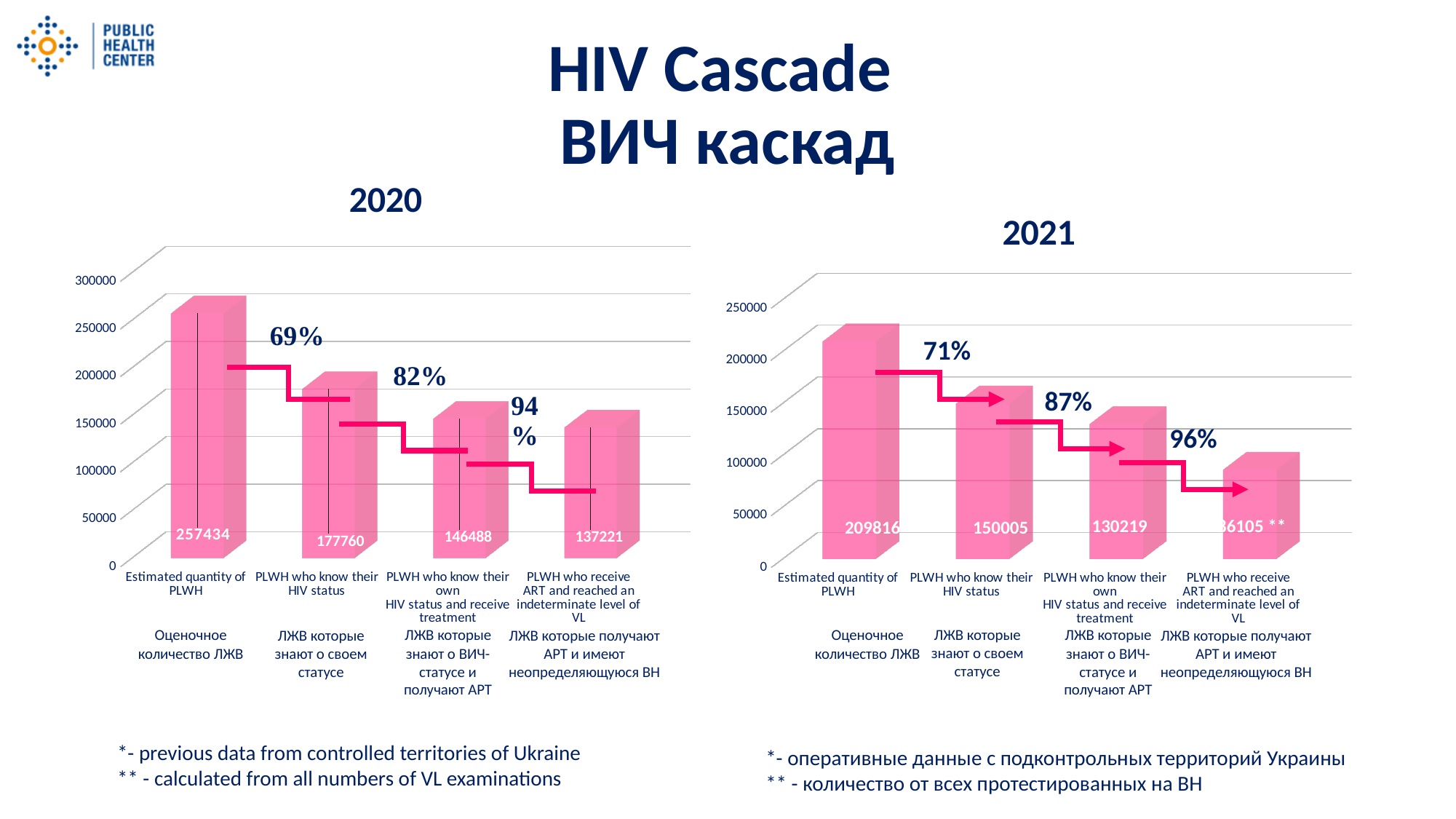
In the 2020 chart, do the values rise or fall from left to right? fall In the 2020 chart, what is the difference between the estimated quantity of PLWH and PLWH who know their HIV status? 79674 In the 2020 chart, which category has the lowest value? PLWH who receive ART and reached an indeterminate level of VL In the 2021 chart, what is the value for PLWH who know their own HIV status and receive treatment? 130219 In the 2021 chart, which category has the highest value? Estimated quantity of PLWH In the 2021 chart, what is the difference between PLWH who know their HIV status and PLWH who know their own HIV status and receive treatment? 19786 Which is larger: the estimated quantity of PLWH in the 2020 chart or in the 2021 chart? 2020 In the 2020 chart, what is the estimated quantity of PLWH? 257434 In the 2021 chart, is the value for PLWH who receive ART and reached an indeterminate level of VL greater or less than 100000? less In the 2020 chart, what is the value for PLWH who know their HIV status? 177760 How many categories are shown in the 2020 chart? 4 In the 2021 chart, what is the estimated quantity of PLWH? 209816